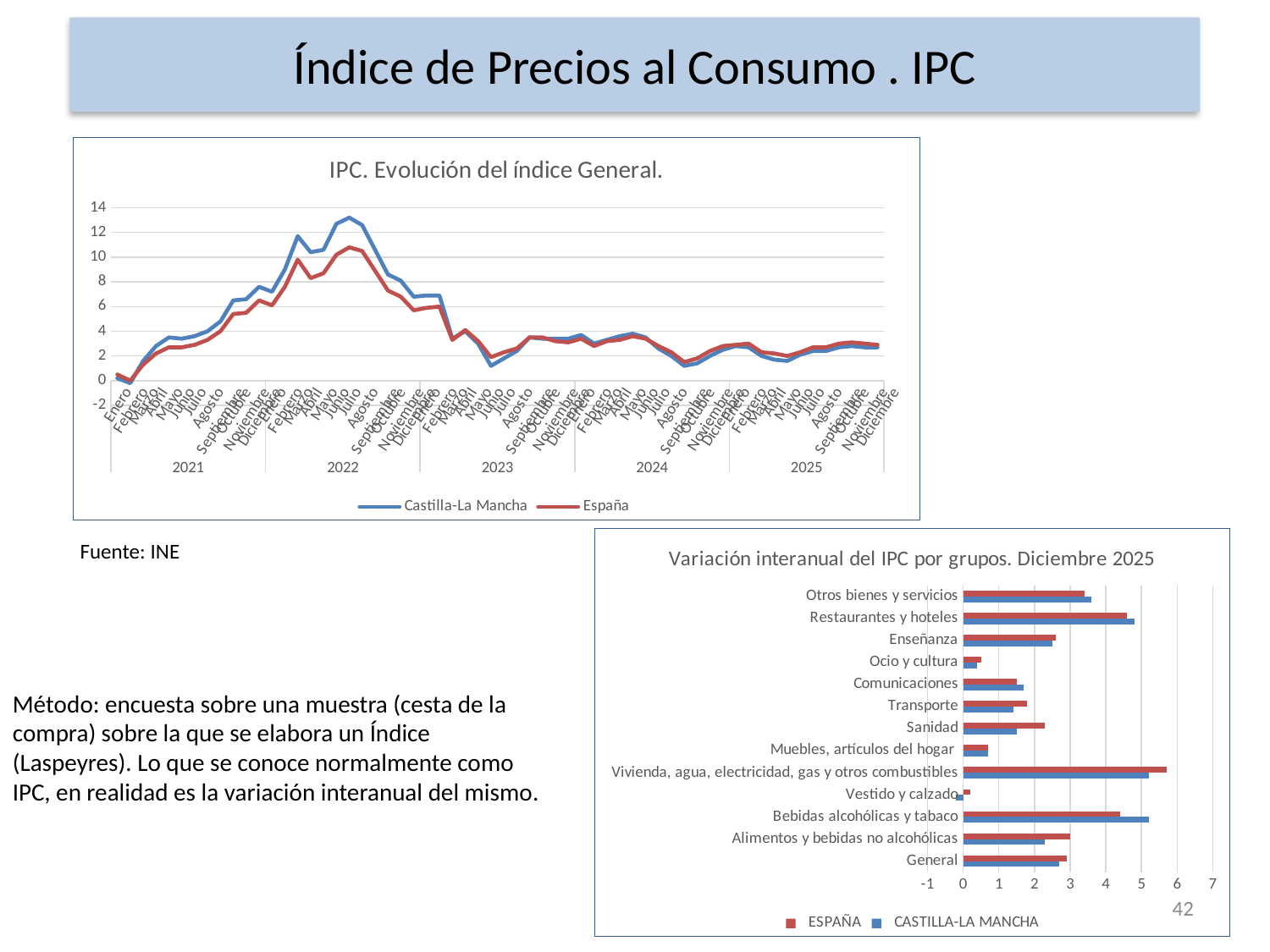
In the chart 'Variación interanual del IPC por grupos. Diciembre 2025', what kind of chart is it? bar chart In the chart 'IPC. Evolución del índice General.', is the peak value for España in 2022 greater or less than 12? less In the chart 'Variación interanual del IPC por grupos. Diciembre 2025', which group has the highest value for ESPAÑA? Vivienda, agua, electricidad, gas y otros combustibles In the chart 'IPC. Evolución del índice General.', what kind of chart is it? line chart In the chart 'IPC. Evolución del índice General.', in which year do both series reach their highest values? 2022 In the chart 'Variación interanual del IPC por grupos. Diciembre 2025', is the ESPAÑA value for Vivienda, agua, electricidad, gas y otros combustibles greater or less than 5? greater In the chart 'Variación interanual del IPC por grupos. Diciembre 2025', how many groups (categories) are shown? 13 In the chart 'IPC. Evolución del índice General.', is the peak value for Castilla-La Mancha in 2022 greater or less than 12? greater In the chart 'IPC. Evolución del índice General.', how many series does the legend list? 2 In the chart 'IPC. Evolución del índice General.', do the values rise or fall from the 2022 peak through 2023? fall In the chart 'Variación interanual del IPC por grupos. Diciembre 2025', for Bebidas alcohólicas y tabaco, which series has the larger value, ESPAÑA or CASTILLA-LA MANCHA? CASTILLA-LA MANCHA In the chart 'Variación interanual del IPC por grupos. Diciembre 2025', which group has the lowest value for CASTILLA-LA MANCHA? Vestido y calzado